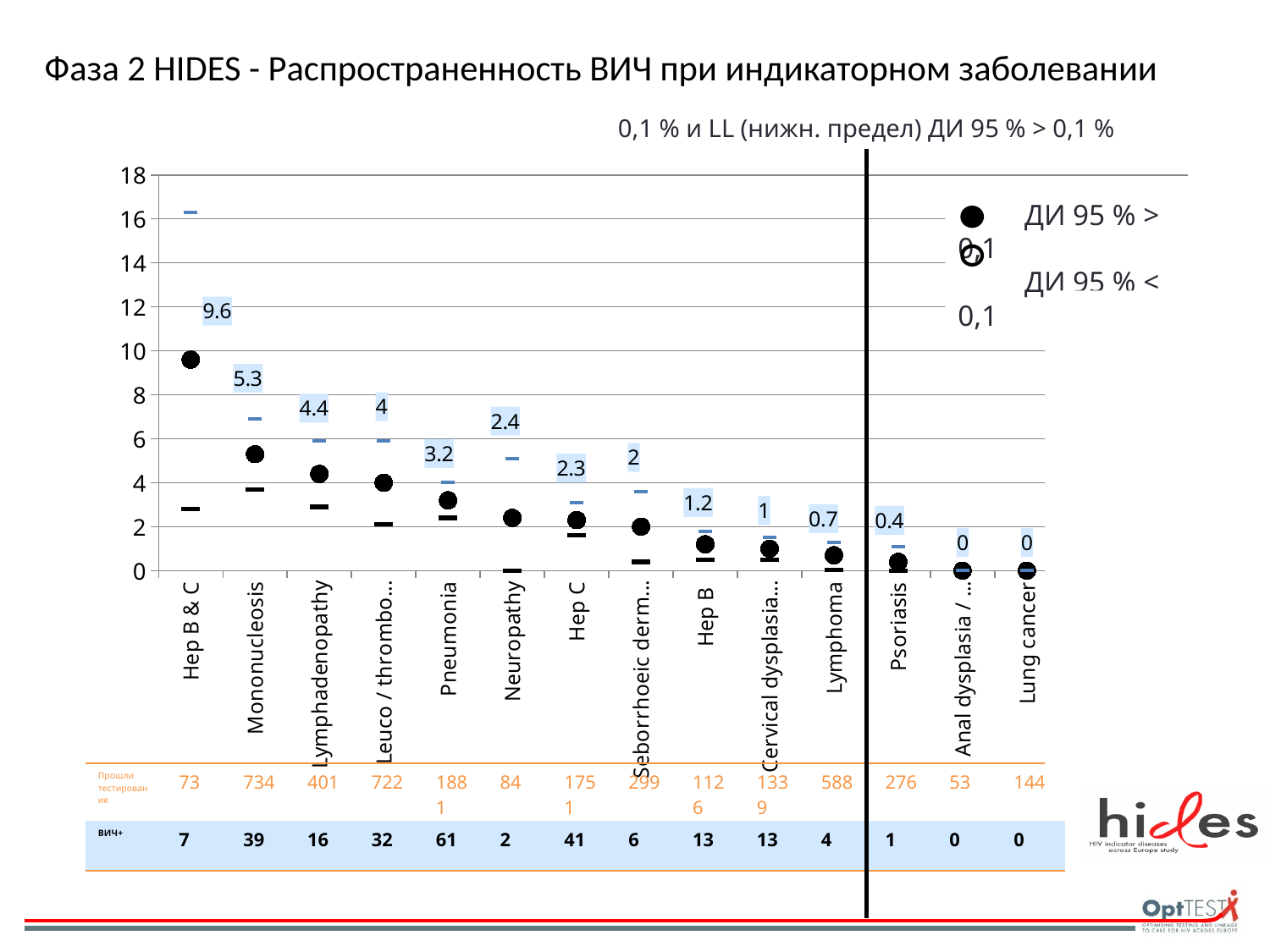
What is the value plotted for Pneumonia? 3.2 Which indicator disease has the highest plotted HIV prevalence? Hep B & C How many indicator diseases are plotted along the x axis? 14 How many entries does the legend list? 2 Is the plotted value for Lymphadenopathy greater or less than 4? greater Do the plotted values rise or fall from left to right along the x axis? fall What is the value plotted for Psoriasis? 0.4 What is the value plotted for Lymphoma? 0.7 What is the value plotted for Mononucleosis? 5.3 What is the HIV prevalence value plotted for Hep B & C? 9.6 Which has a larger plotted value, Neuropathy or Hep B? Neuropathy What is the difference between the plotted values for Hep B & C and Mononucleosis? 4.3